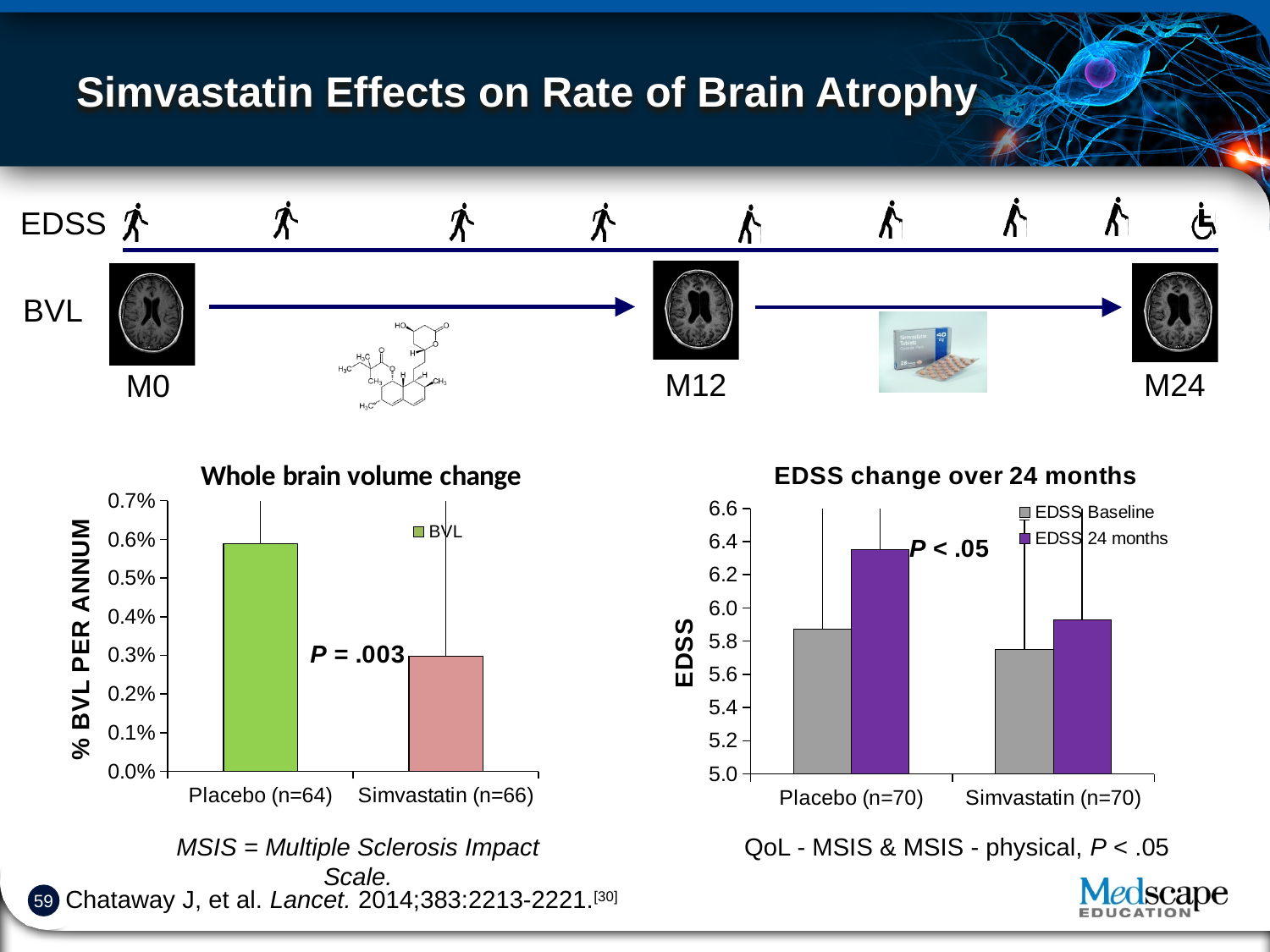
What type of chart is the "Whole brain volume change" chart? bar chart In the "EDSS change over 24 months" chart, is the EDSS 24 months value for Simvastatin (n=70) greater or less than 6.0? less In the "EDSS change over 24 months" chart, which group has the higher EDSS 24 months value, Placebo (n=70) or Simvastatin (n=70)? Placebo (n=70) In the "EDSS change over 24 months" chart, is the EDSS Baseline value for Simvastatin (n=70) greater or less than 5.6? greater In the "Whole brain volume change" chart, is the value for Simvastatin (n=66) greater or less than 0.4%? less What P value is printed on the "Whole brain volume change" chart? P = .003 In the "Whole brain volume change" chart, which group has the higher % BVL per annum? Placebo (n=64) What is the y-axis label of the "EDSS change over 24 months" chart? EDSS How many series does the legend of the "EDSS change over 24 months" chart list? 2 How many categories are shown on the x axis of the "Whole brain volume change" chart? 2